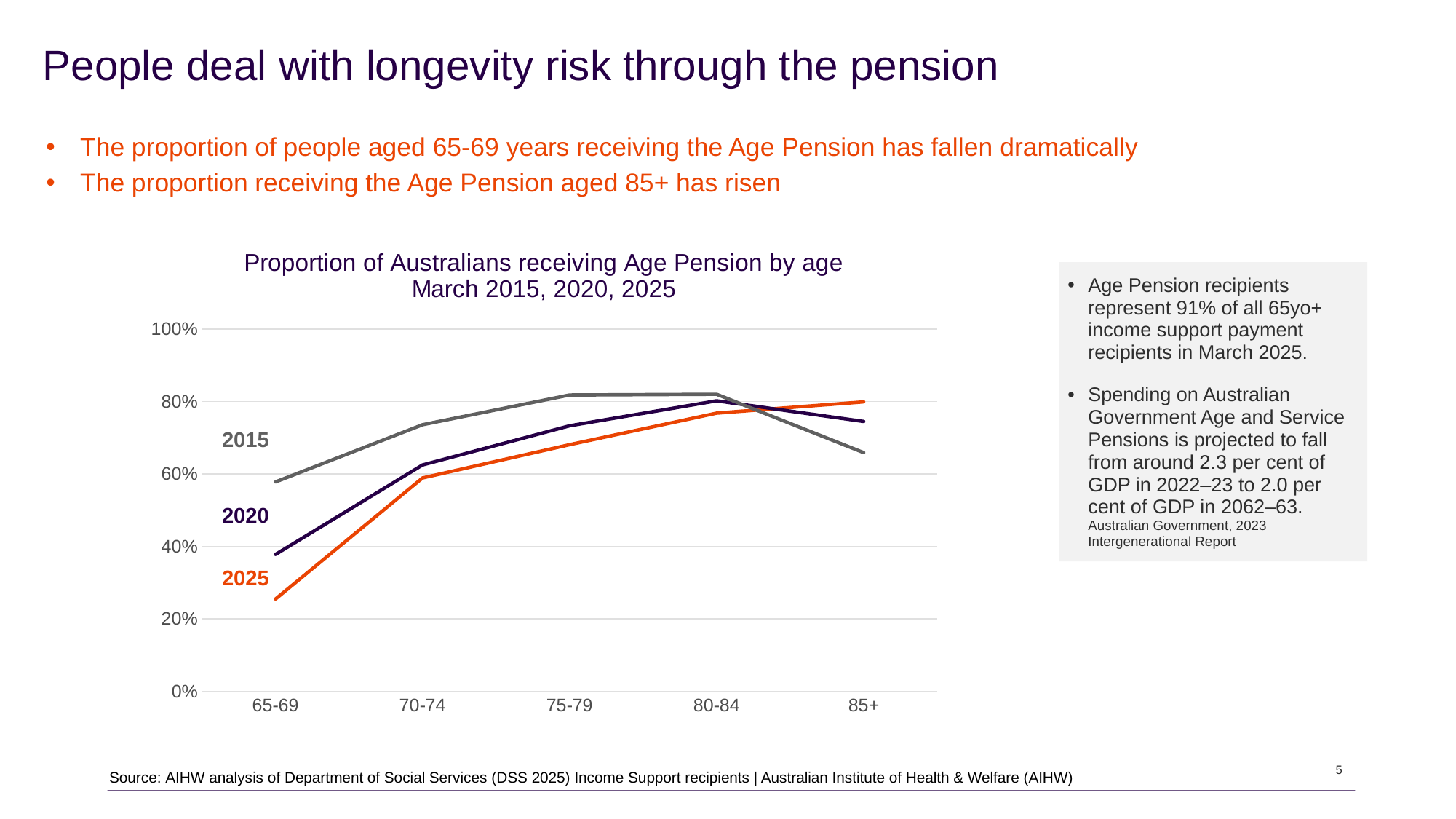
Is the 2020 value for the 70-74 age group greater or less than 40%? greater How many age groups are shown on the x axis of the chart? 5 Is the 2015 value for the 65-69 age group greater or less than 40%? greater Is the 2025 value for the 65-69 age group greater or less than 40%? less What kind of chart is shown on the slide? line chart For the 65-69 age group, which series has the larger value, 2015 or 2025? 2015 Which years are plotted as series on the chart? 2015, 2020, 2025 Does the 2025 series rise or fall as age increases from 65-69 to 85+? rise How many series (years) are plotted on the chart? 3 For the 85+ age group, which series has the larger value, 2015 or 2025? 2025 Which age group has the lowest value in the 2025 series? 65-69